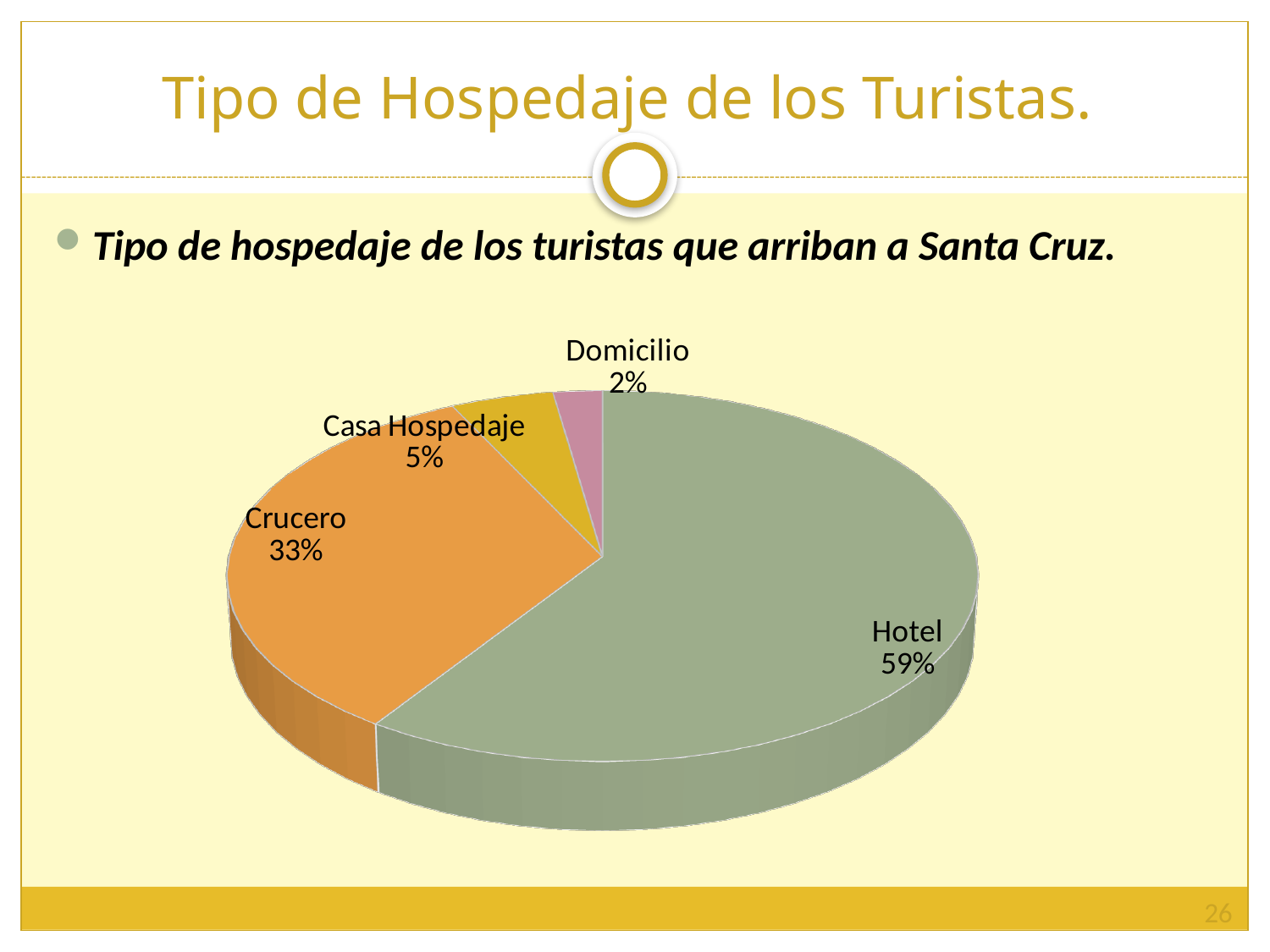
What is the value shown for Crucero? 33% What is the value shown for Domicilio? 2% What kind of chart is shown on the slide? Pie chart Which is larger, Casa Hospedaje or Domicilio? Casa Hospedaje Which category has the smallest slice of the pie? Domicilio What is the value shown for Casa Hospedaje? 5% Which category has the largest slice of the pie? Hotel How many categories are shown in the pie chart? 4 What is the combined share of Crucero and Casa Hospedaje? 38% What colour is the Crucero slice? Orange What share of the pie does Hotel represent? 59% What is the difference in percentage points between Hotel and Crucero? 26